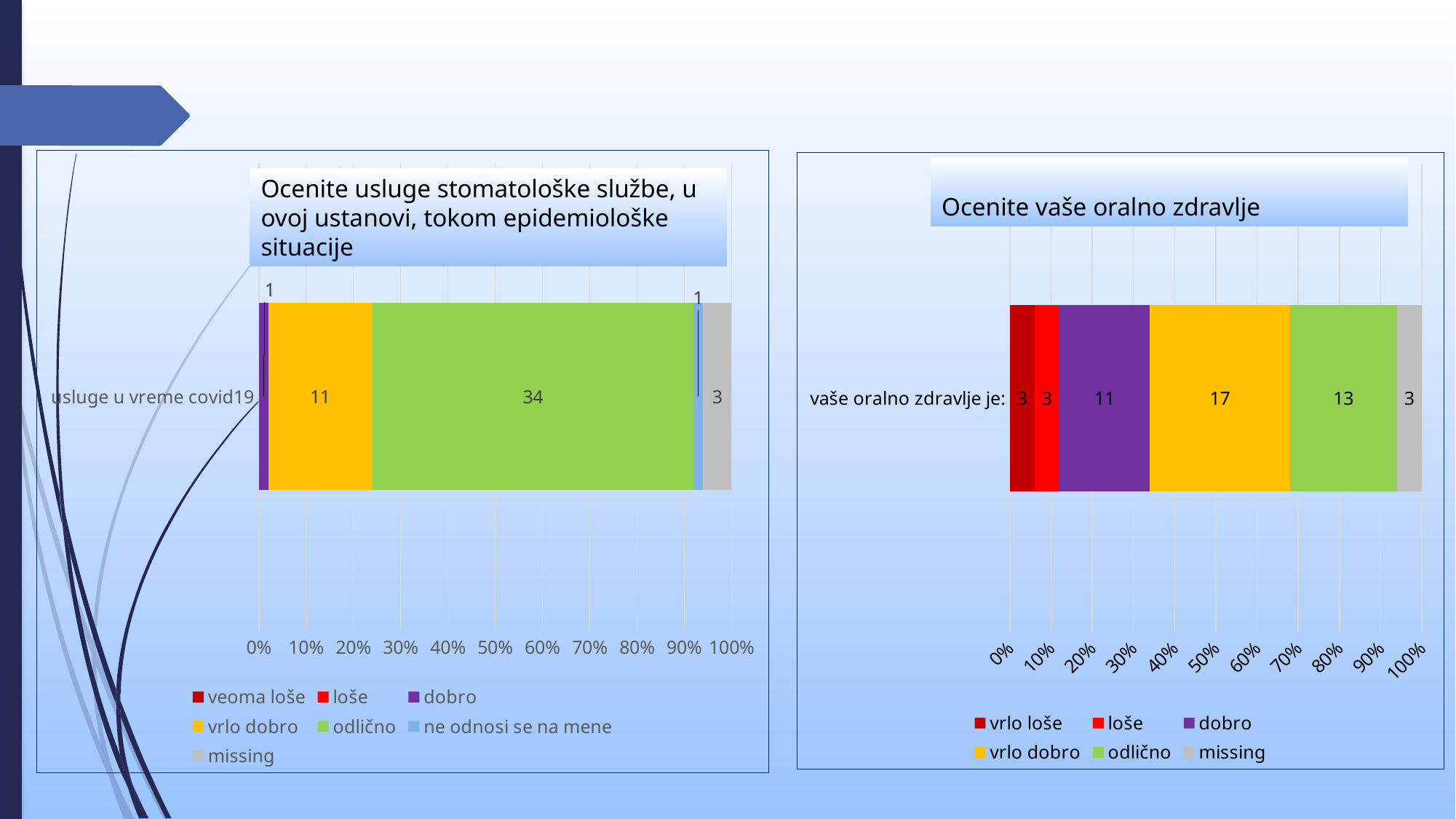
In the chart titled "Ocenite vaše oralno zdravlje", what is the value for "vrlo dobro"? 17 In the chart titled "Ocenite vaše oralno zdravlje", which legend category has the highest value? vrlo dobro In the chart titled "Ocenite vaše oralno zdravlje", what is the difference between the values for "vrlo dobro" and "odlično"? 4 In the chart titled "Ocenite vaše oralno zdravlje", what is the total of all segments in the stacked bar? 50 In the chart titled "Ocenite vaše oralno zdravlje", how many series does the legend list? 6 In the left chart ("Ocenite usluge stomatološke službe..."), what is the value for "missing"? 3 What kind of chart is the chart titled "Ocenite vaše oralno zdravlje"? Stacked bar chart In the left chart ("Ocenite usluge stomatološke službe..."), which is larger, the value for "odlično" or the value for "vrlo dobro"? odlično In the left chart ("Ocenite usluge stomatološke službe..."), what is the value for "odlično"? 34 In the left chart ("Ocenite usluge stomatološke službe..."), how many series does the legend list? 7 In the chart titled "Ocenite vaše oralno zdravlje", what is the value for "dobro"? 11 In the left chart ("Ocenite usluge stomatološke službe..."), what is the value for "vrlo dobro"? 11